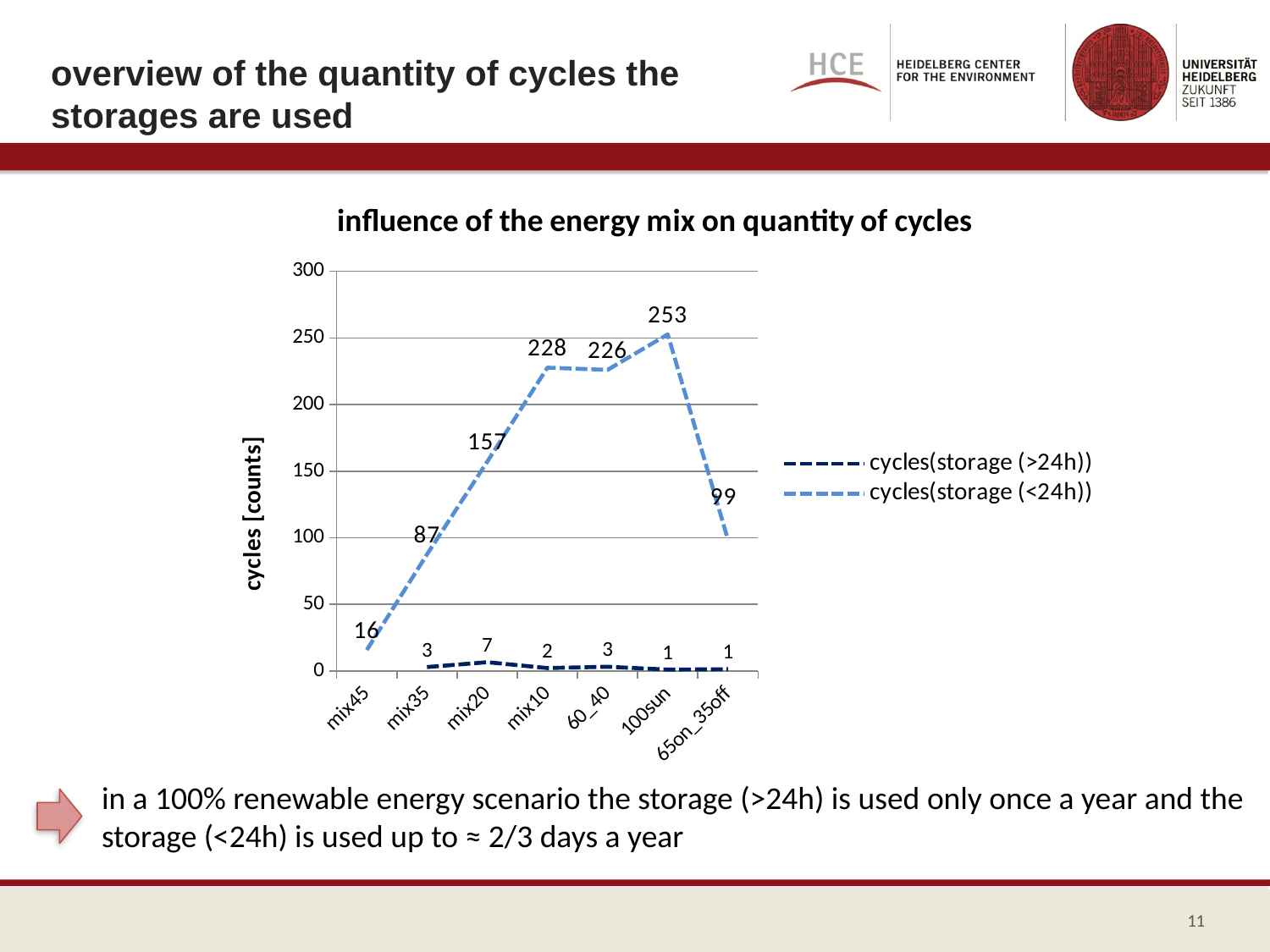
How many series does the legend list? 2 Which category has the highest value for cycles(storage (<24h))? 100sun What is the value of cycles(storage (<24h)) for 65on_35off? 99 How many categories are shown on the x axis? 7 What is the value of cycles(storage (>24h)) for mix20? 7 Which is larger, the cycles(storage (<24h)) value for mix35 or for mix20? mix20 Is the value of cycles(storage (<24h)) for mix10 greater or less than 200? greater Which category has the lowest value for cycles(storage (<24h))? mix45 What is the value of cycles(storage (<24h)) for mix45? 16 What type of chart is shown on the slide? line chart What is the difference between the cycles(storage (<24h)) values for mix10 and 60_40? 2 What is the value of cycles(storage (<24h)) for 100sun? 253